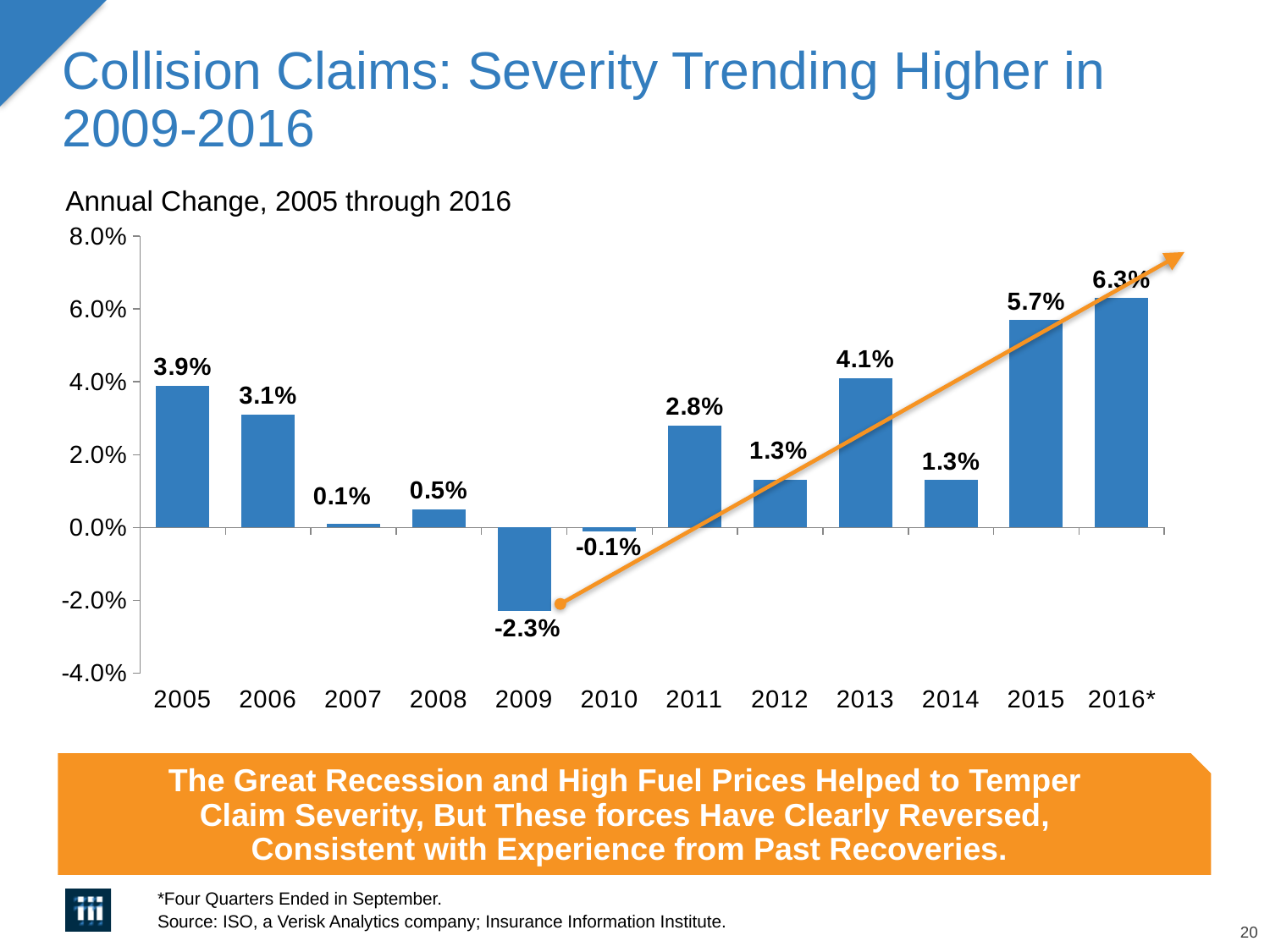
What is the annual change shown for 2016*? 6.3% Is the value for 2015 greater or less than 4.0%? greater How many years are shown on the x axis of the chart? 12 What kind of chart is shown on the slide? Bar chart Which year has the larger annual change, 2011 or 2012? 2011 What is the difference between the annual change in 2005 and in 2006? 0.8% What is the difference between the annual change in 2016* and in 2015? 0.6% Which year has the highest annual change in the chart? 2016* What is the annual change shown for 2013? 4.1% Which year has the lowest annual change in the chart? 2009 Do the annual change values generally rise or fall from 2009 to 2016*? Rise What is the annual change in collision claim severity for 2009? -2.3%